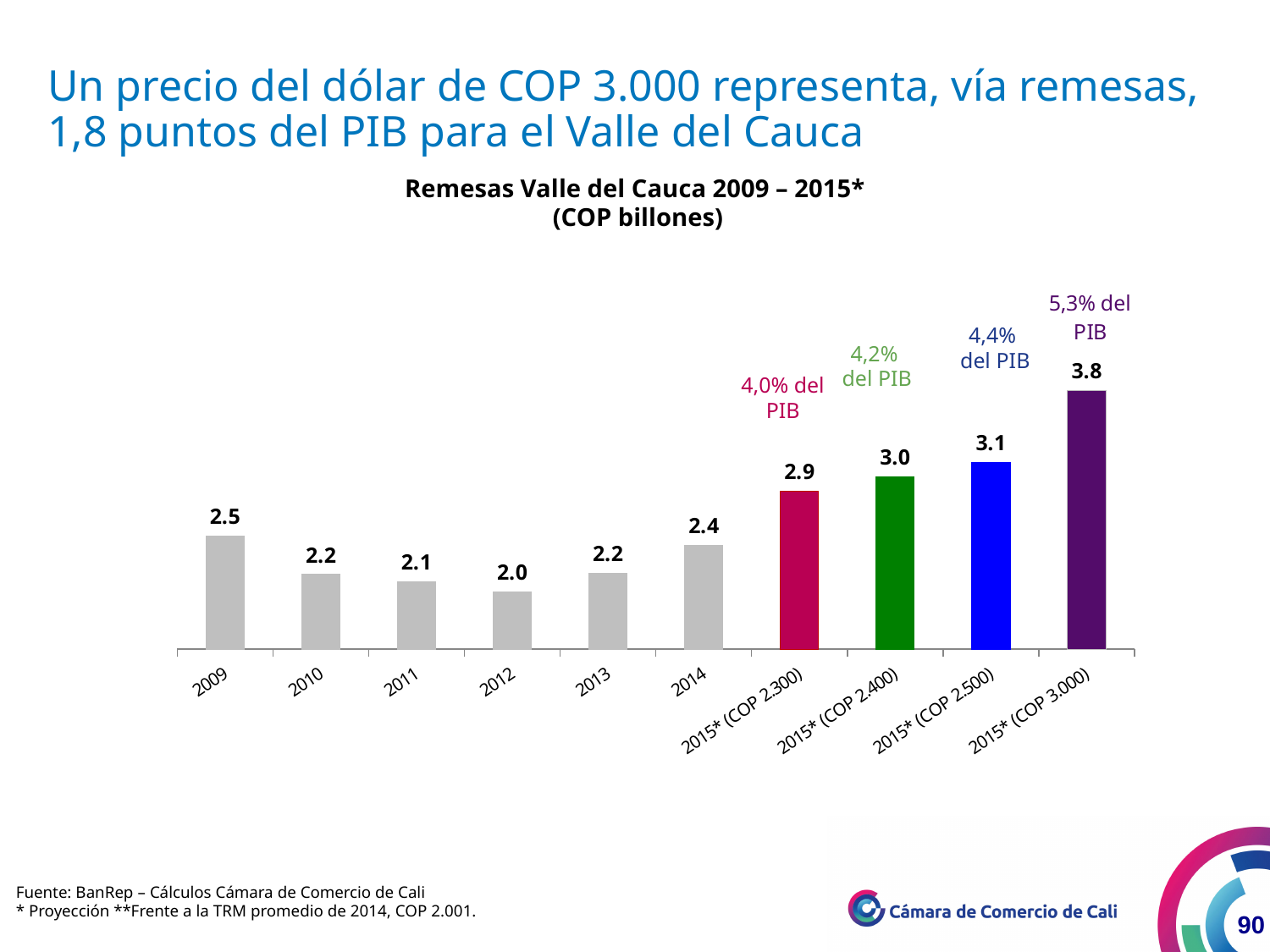
What kind of chart is shown on the slide? Bar chart What is the value for 2012? 2.0 What share of PIB is annotated above the 2015* (COP 2.500) bar? 4,4% del PIB What is the difference between the values for 2015* (COP 3.000) and 2014? 1.4 Which category has the lowest value? 2012 What is the value for 2015* (COP 2.400)? 3.0 Do the values rise or fall from 2015* (COP 2.300) to 2015* (COP 3.000)? Rise What is the value for 2015* (COP 3.000)? 3.8 Which is larger, the value for 2009 or the value for 2013? 2009 How many bars are shown in the chart? 10 What is the value for 2009? 2.5 Which category has the highest value? 2015* (COP 3.000)